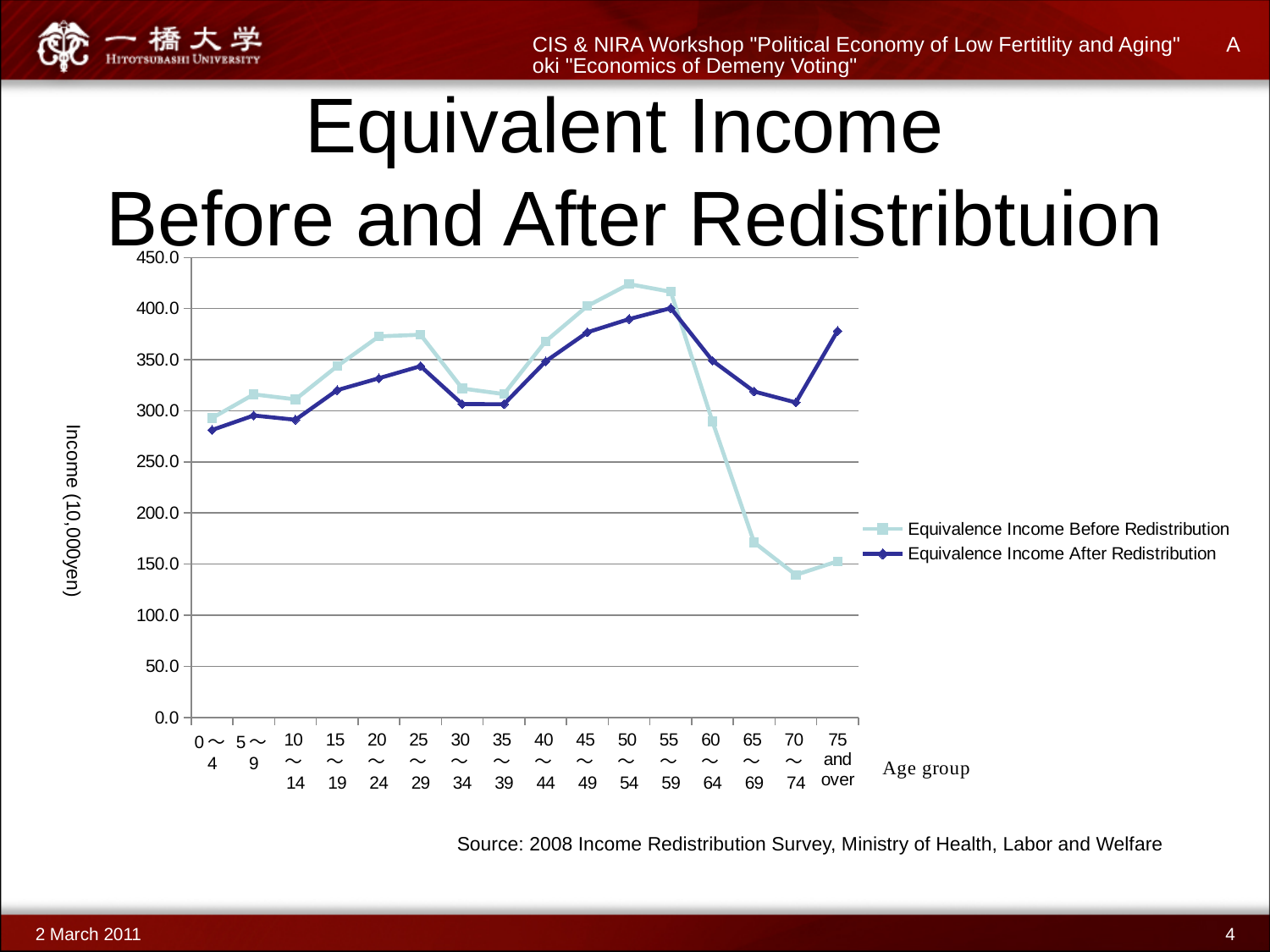
Which age group has the highest Equivalence Income Before Redistribution? 50～54 How many age groups are plotted along the x axis? 16 What is the label of the y axis? Income (10,000yen) Which age group has the highest Equivalence Income After Redistribution? 55～59 What kind of chart is shown on the slide? line chart Is the Equivalence Income After Redistribution for the 75 and over age group greater or less than 350? greater Which age group has the lowest Equivalence Income Before Redistribution? 70～74 Is the Equivalence Income Before Redistribution for the 70～74 age group greater or less than 150? less How many series does the legend list? 2 For the 75 and over age group, which is larger: Equivalence Income Before Redistribution or Equivalence Income After Redistribution? Equivalence Income After Redistribution Does the Equivalence Income Before Redistribution rise or fall from the 55～59 age group to the 70～74 age group? fall Is the Equivalence Income Before Redistribution for the 50～54 age group greater or less than 400? greater